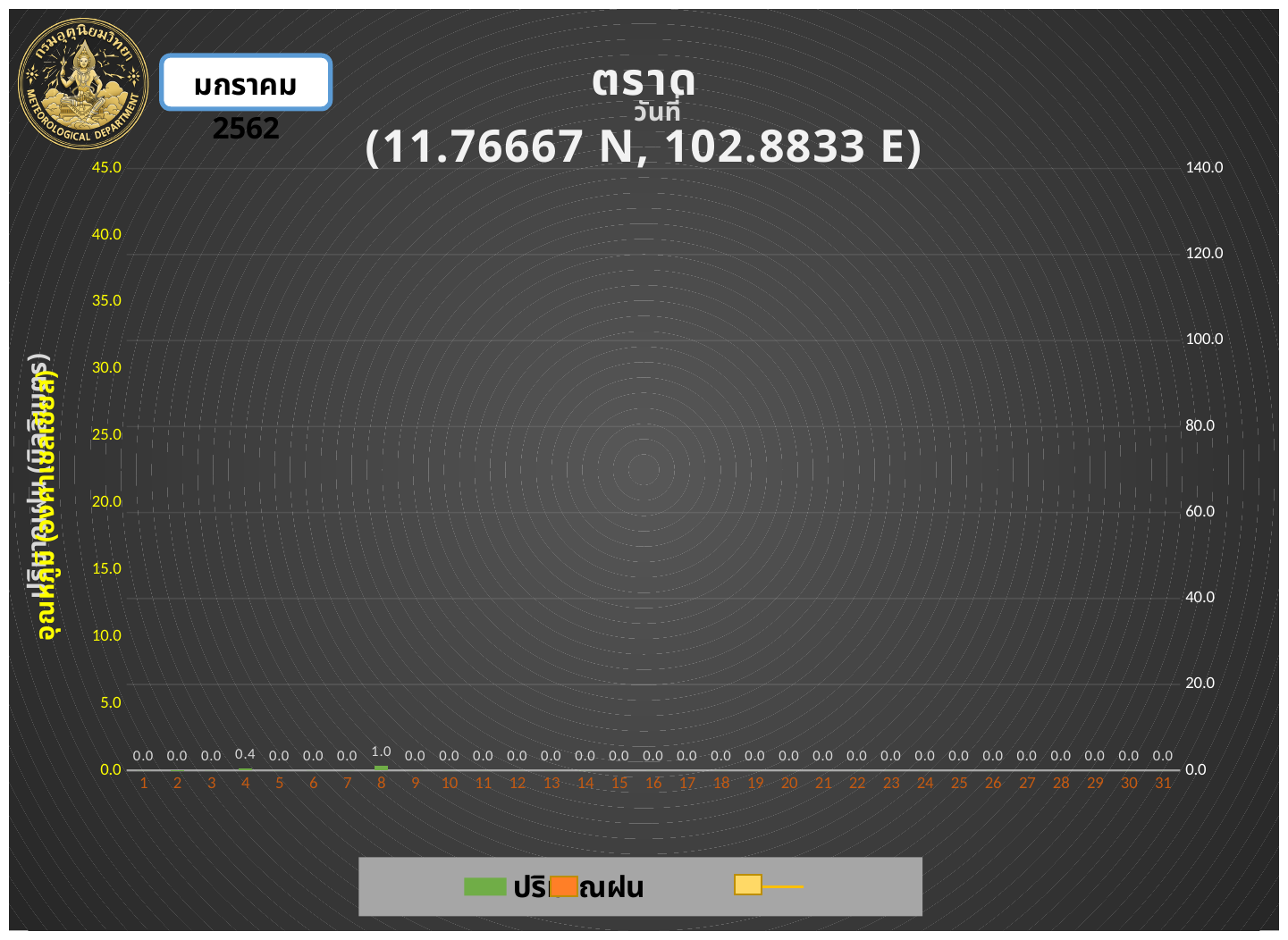
What is the highest tick value on the right-hand axis? 140.0 Which is larger, the value for day 4 or the value for day 8? day 8 Is the value for day 8 greater or less than 5.0 on the left axis? less What kind of chart is this? bar chart What is the value shown for day 8? 1.0 What is the difference between the values for day 8 and day 4? 0.6 How many days are shown on the x axis? 31 What is the value shown for day 4? 0.4 What is the title of the chart? ตราด (11.76667 N, 102.8833 E) What is the value shown for day 15? 0.0 Which day has the highest value? 8